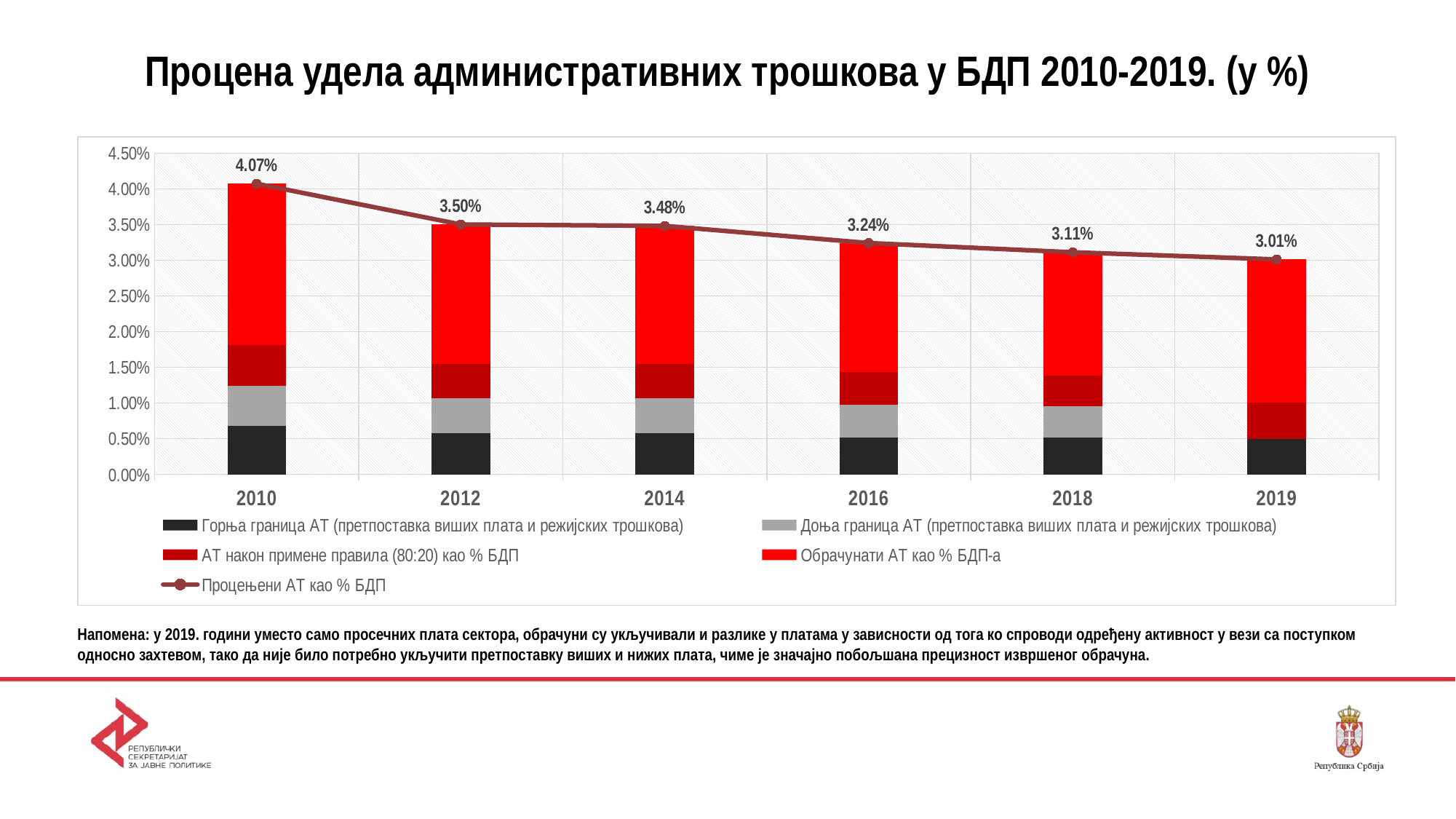
What kind of chart is shown on the slide? Stacked bar chart with a line In which year is the Процењени АТ као % БДП line highest? 2010 What is the value of the Процењени АТ као % БДП line for 2016? 3.24% Does the Процењени АТ као % БДП line rise or fall from 2010 to 2019? Fall How many series does the legend list? 5 Which year has a larger Процењени АТ као % БДП value, 2012 or 2018? 2012 What is the difference between the Процењени АТ као % БДП values for 2010 and 2019? 1.06 percentage points What is the value of the Процењени АТ као % БДП line for 2010? 4.07% How many years are shown on the x axis of the chart? 6 What is the value of the Процењени АТ као % БДП line for 2019? 3.01% Is the value of the Горња граница АТ segment for 2010 greater or less than 0.50%? greater In which year is the Процењени АТ као % БДП line lowest? 2019